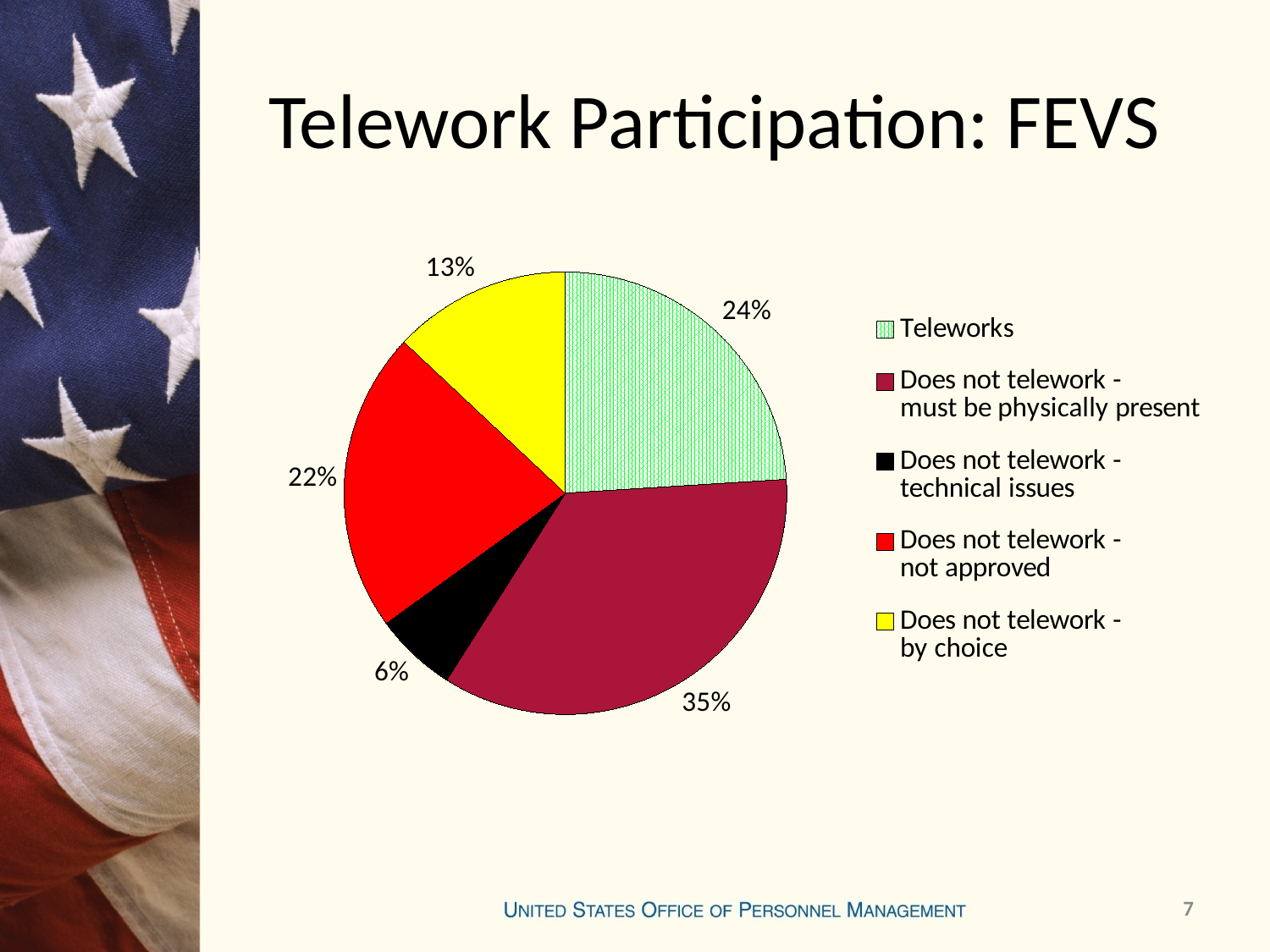
What share of the pie is 'Does not telework - must be physically present'? 35% How many categories does the pie chart have? 5 What kind of chart is shown on the slide? pie chart What is the difference between the 'must be physically present' share and the 'Teleworks' share? 11% What percentage does not telework because it is not approved? 22% Which category has the largest slice of the pie? Does not telework - must be physically present Which category has the smallest slice of the pie? Does not telework - technical issues What percentage does not telework by choice? 13% What percentage of respondents teleworks? 24% Which is larger: the 'Does not telework - not approved' slice or the 'Does not telework - by choice' slice? Does not telework - not approved What is the title of the slide containing the pie chart? Telework Participation: FEVS What percentage does not telework due to technical issues? 6%